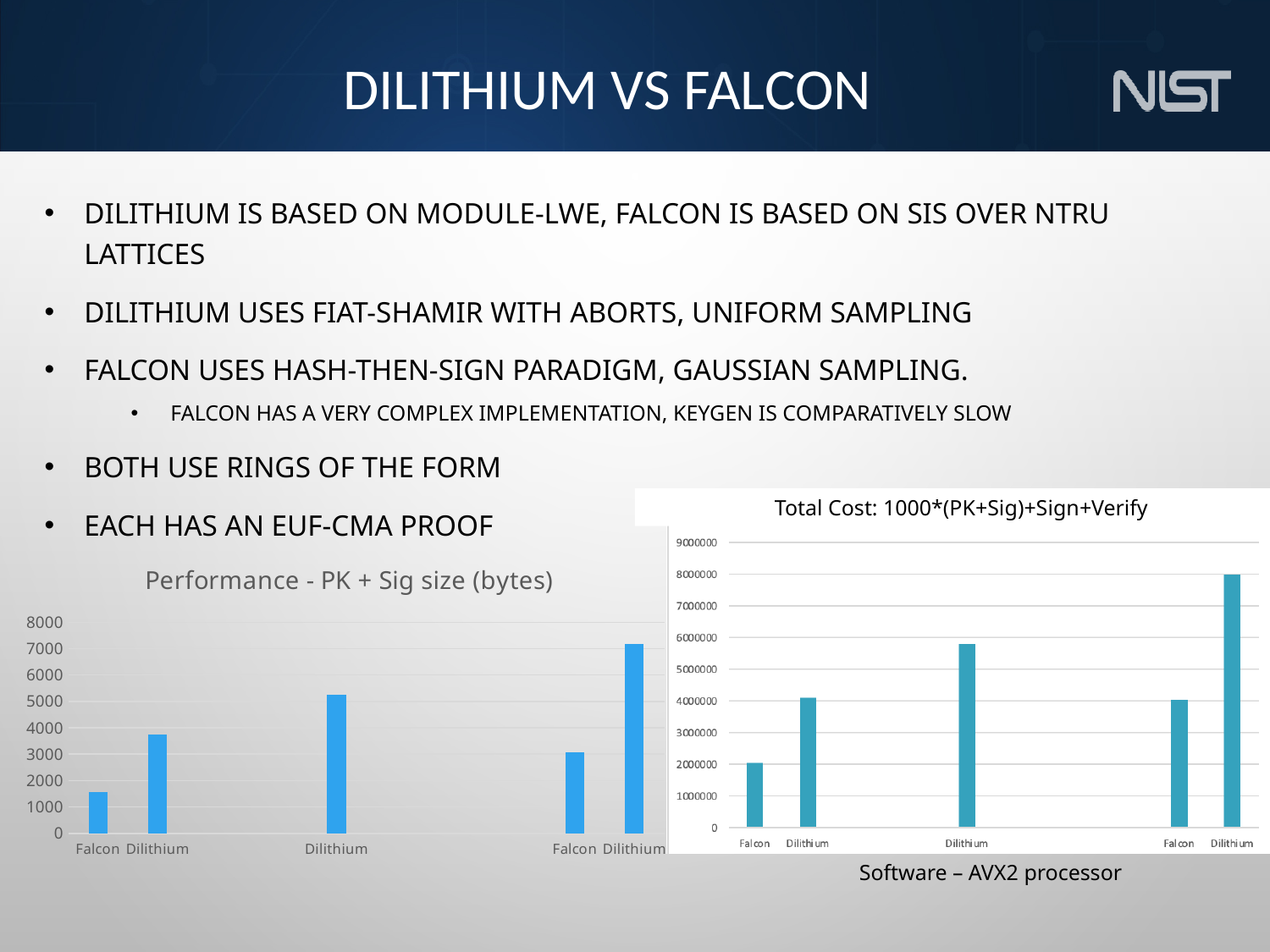
In the 'Performance - PK + Sig size (bytes)' chart, which bar is the shortest? the leftmost Falcon bar In the 'Total Cost: 1000*(PK+Sig)+Sign+Verify' chart, is the value of the middle Dilithium bar greater or less than 5000000? greater How many bars are plotted in the 'Total Cost: 1000*(PK+Sig)+Sign+Verify' chart? 5 In the 'Performance - PK + Sig size (bytes)' chart, is the value of the rightmost Dilithium bar greater or less than 6000? greater How many bars are plotted in the 'Performance - PK + Sig size (bytes)' chart? 5 What kind of chart is the 'Performance - PK + Sig size (bytes)' chart? bar chart In the 'Performance - PK + Sig size (bytes)' chart, which is larger: the leftmost Falcon bar or the Dilithium bar next to it? the Dilithium bar What kind of chart is the 'Total Cost: 1000*(PK+Sig)+Sign+Verify' chart? bar chart In the 'Performance - PK + Sig size (bytes)' chart, is the value of the leftmost Falcon bar greater or less than 2000? less In the 'Performance - PK + Sig size (bytes)' chart, which bar is the tallest? the rightmost Dilithium bar In the 'Total Cost: 1000*(PK+Sig)+Sign+Verify' chart, which bar is the tallest? the rightmost Dilithium bar What is the title of the chart on the right side of the slide? Total Cost: 1000*(PK+Sig)+Sign+Verify